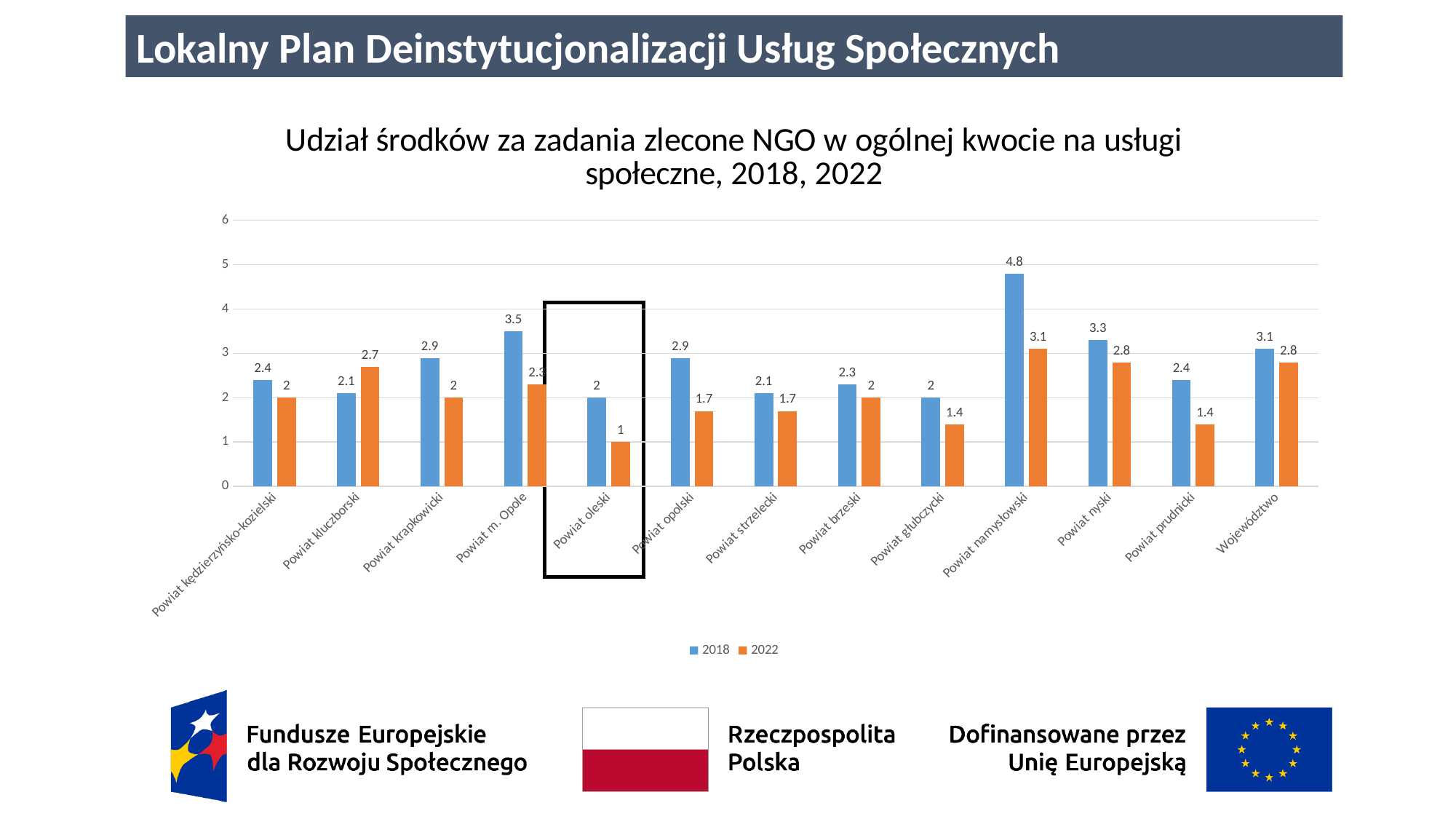
Which category on the chart is outlined with a black rectangle? Powiat oleski Which category has the lowest 2022 value? Powiat oleski How many categories are shown on the x axis? 13 Which colour represents the 2022 series in the chart? orange What type of chart is shown on the slide? bar chart Which category has the highest 2018 value? Powiat namysłowski What is the 2022 value for Powiat oleski? 1 What is the difference between the 2018 and 2022 values for Powiat m. Opole? 1.2 What is the 2018 value for Powiat namysłowski? 4.8 What is the 2022 value for Województwo? 2.8 Which is larger for Powiat kluczborski, the 2018 value or the 2022 value? 2022 How many series does the legend list? 2